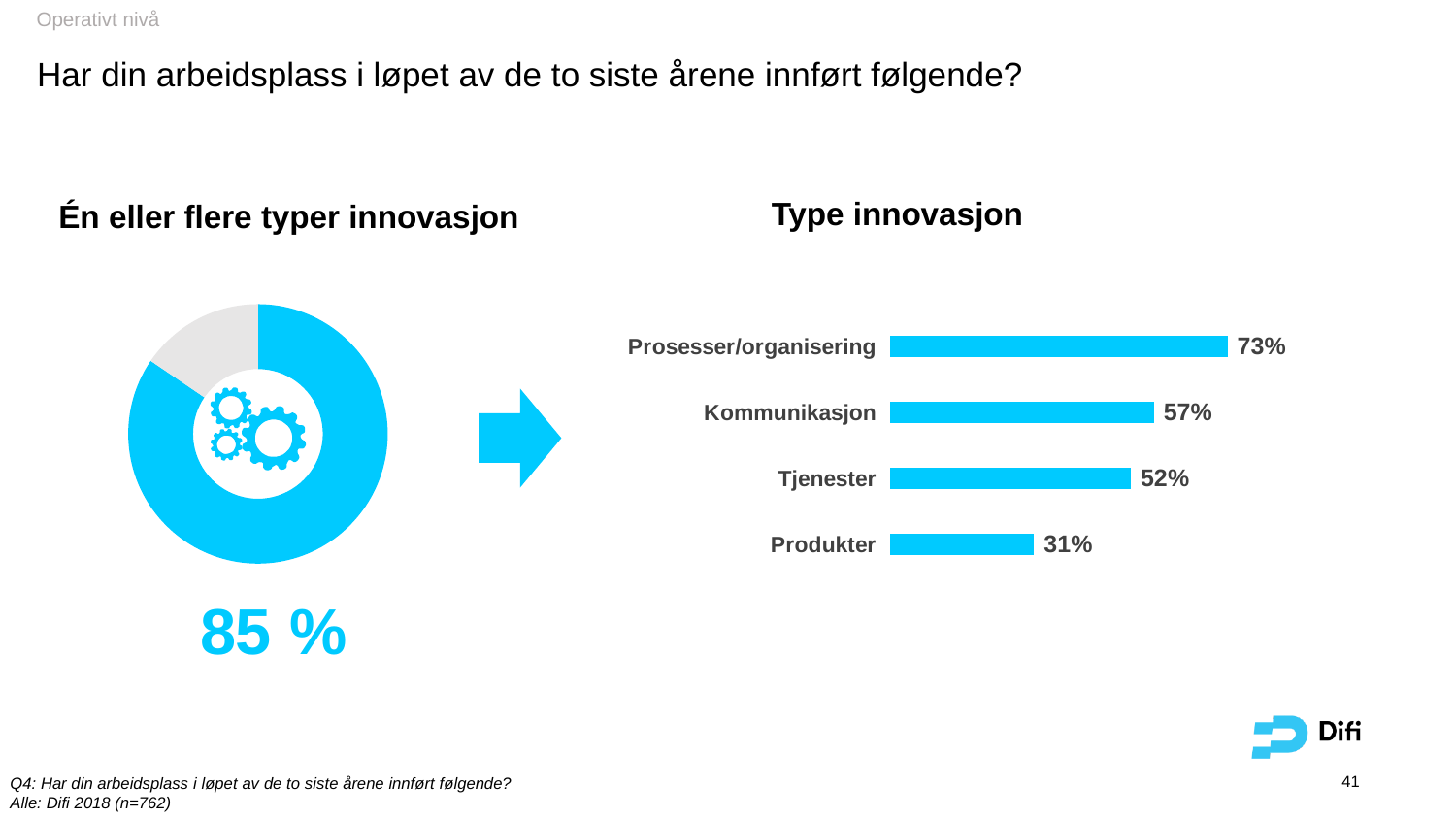
In the 'Type innovasjon' chart, what is the value for Produkter? 31% In the 'Type innovasjon' chart, which category has the lowest value? Produkter What kind of chart is shown under 'Én eller flere typer innovasjon'? Donut chart In the 'Type innovasjon' chart, what is the difference between Prosesser/organisering and Produkter? 42% In the 'Type innovasjon' chart, which category has the highest value? Prosesser/organisering What kind of chart is the 'Type innovasjon' chart? Bar chart How many categories are shown in the 'Type innovasjon' chart? 4 In the 'Type innovasjon' chart, what is the value for Kommunikasjon? 57% In the 'Type innovasjon' chart, what is the value for Prosesser/organisering? 73% In the 'Type innovasjon' chart, what is the value for Tjenester? 52% What percentage is shown for the 'Én eller flere typer innovasjon' donut chart? 85 % In the 'Type innovasjon' chart, which is larger: Kommunikasjon or Tjenester? Kommunikasjon